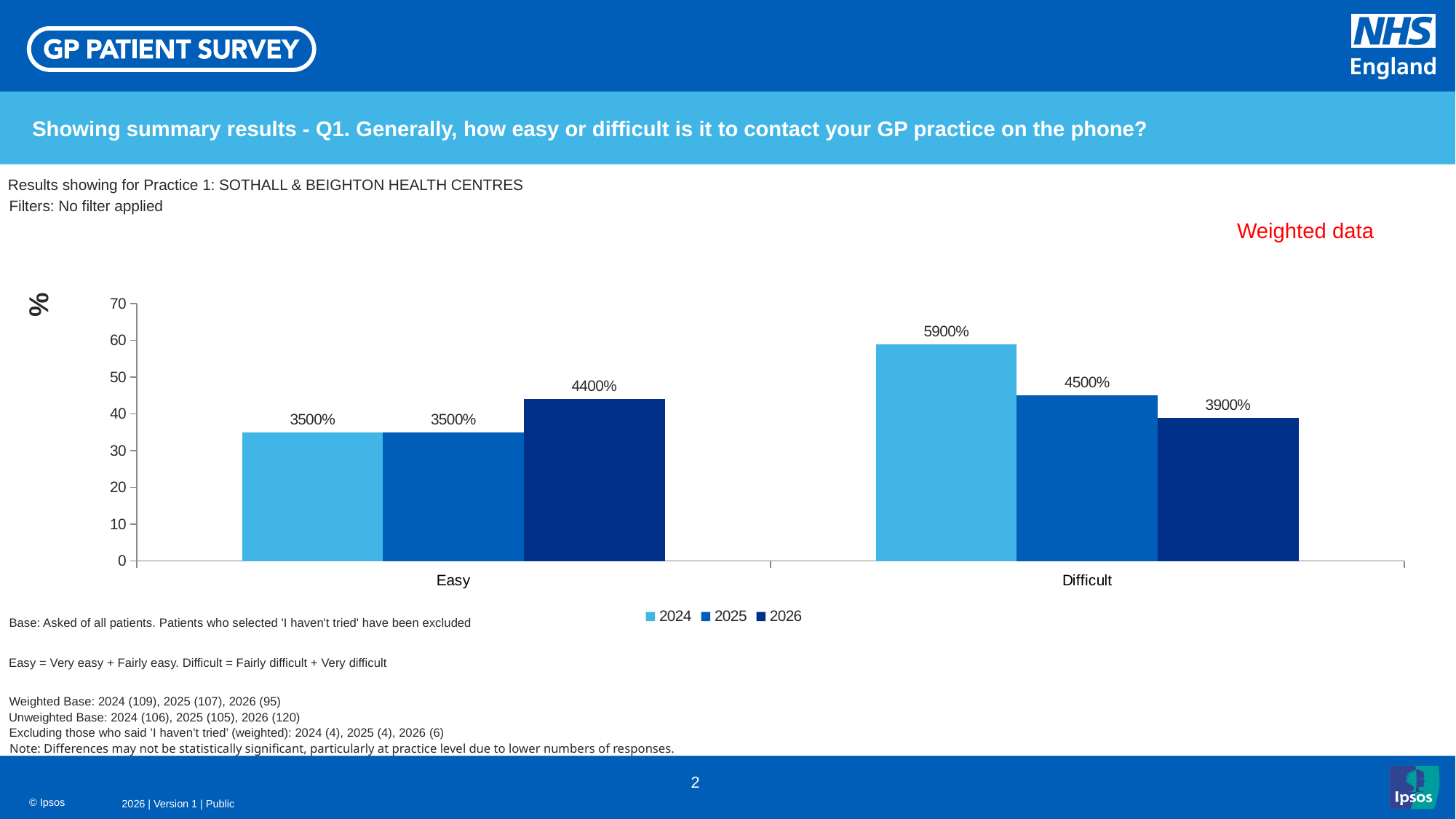
How many series does the legend list? 3 What is the value for 2024 in the Difficult category? 5900% Do the values in the Difficult category rise or fall from 2024 to 2026? Fall Which is larger: the 2026 value for Easy or the 2026 value for Difficult? 2026 value for Easy What is the value for 2025 in the Difficult category? 4500% What is the value for 2024 in the Easy category? 3500% What kind of chart is shown on the slide? Bar chart What is the value for 2026 in the Difficult category? 3900% What is the difference between the 2024 and 2026 values in the Difficult category? 2000% Which year has the highest value in the Difficult category? 2024 What is the value for 2026 in the Easy category? 4400% Which year has the lowest value in the Difficult category? 2026